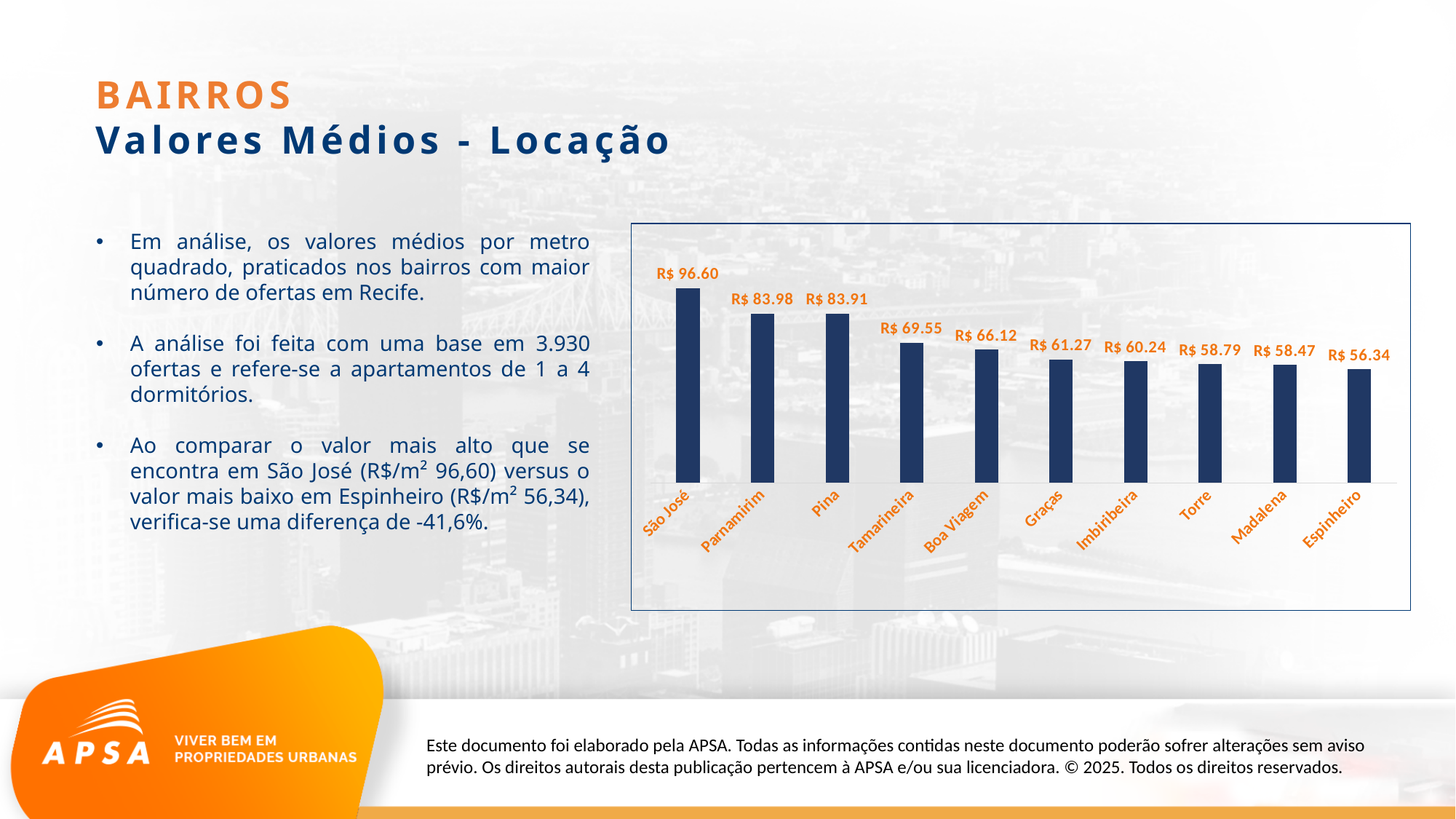
What is the difference between the values for Tamarineira and Boa Viagem? R$ 3.43 What is the value shown for São José? R$ 96.60 What is the value shown for Imbiribeira? R$ 60.24 How many neighbourhoods are shown in the chart? 10 Which has a larger value, Graças or Madalena? Graças What is the value shown for Boa Viagem? R$ 66.12 Which neighbourhood has the lowest value in the chart? Espinheiro Do the values rise or fall from left to right across the chart? Fall What is the difference between the values for São José and Espinheiro? R$ 40.26 What is the value shown for Torre? R$ 58.79 What kind of chart is shown on the slide? Bar chart Which neighbourhood has the highest value in the chart? São José